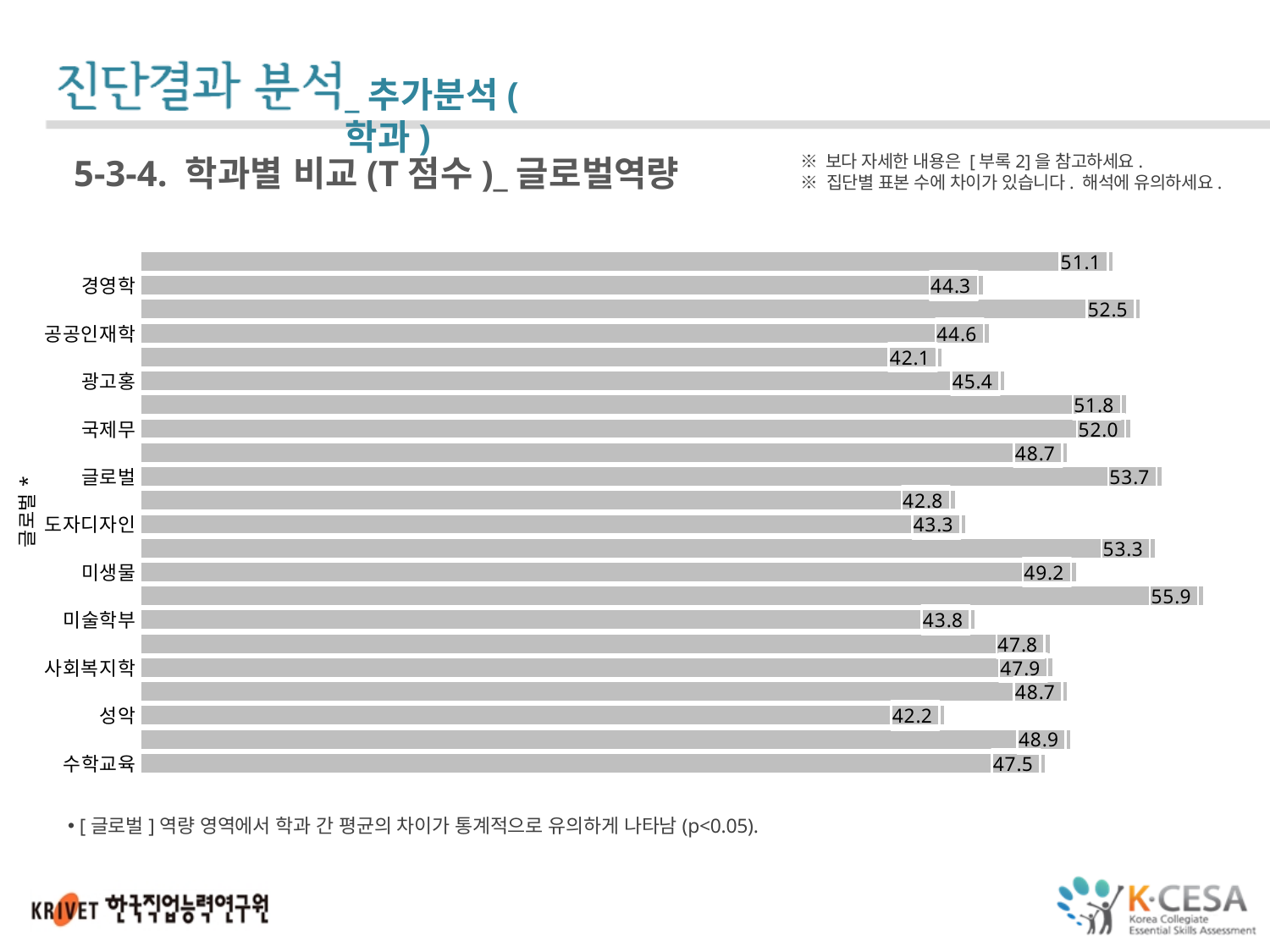
What kind of chart is shown on the slide? bar chart What is the largest value printed on any bar in the chart? 55.9 What is the value of the bar labelled 글로벌? 53.7 What is the difference between the values for 미생물 and 미술학부? 5.4 Which has the larger value, 국제무 or 성악? 국제무 What is the value of the bar labelled 미생물? 49.2 What is the value of the bar labelled 경영학? 44.3 What is the value of the bar labelled 성악? 42.2 What is the value of the bar labelled 수학교육? 47.5 How many bars are plotted in the chart? 22 What is the difference between the values for 글로벌 and 경영학? 9.4 What is the smallest value printed on any bar in the chart? 42.1